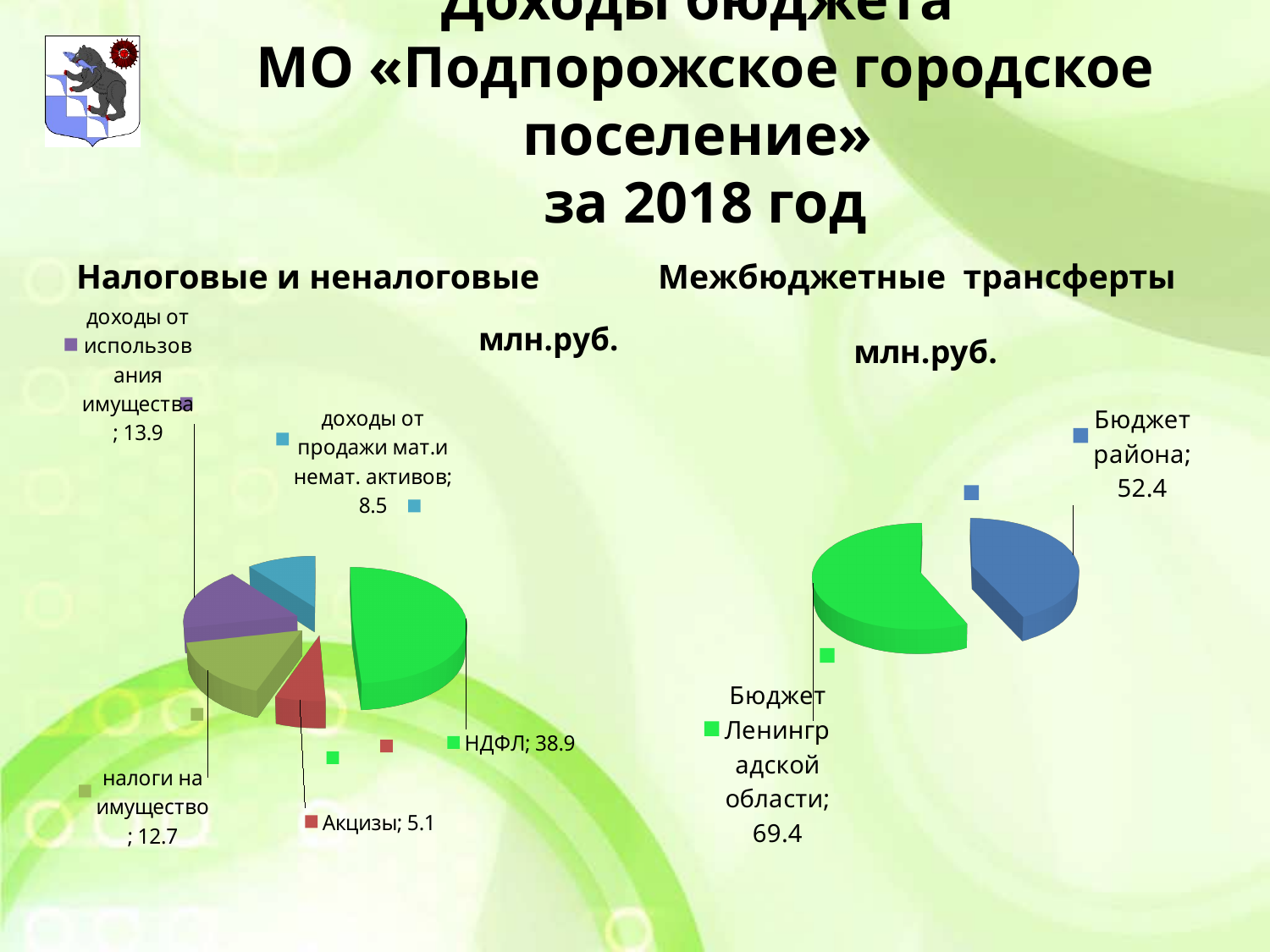
In the «Межбюджетные трансферты» chart, what is the value for Бюджет Ленинградской области? 69.4 In the «Налоговые и неналоговые» chart, how many categories are shown? 5 In the «Налоговые и неналоговые» chart, what is the value for НДФЛ? 38.9 In the «Налоговые и неналоговые» chart, what is the value for налоги на имущество? 12.7 In the «Налоговые и неналоговые» chart, what is the difference between НДФЛ and доходы от использования имущества? 25.0 In the «Налоговые и неналоговые» chart, which category has the largest value? НДФЛ In the «Межбюджетные трансферты» chart, what is the value for Бюджет района? 52.4 In the «Межбюджетные трансферты» chart, what is the difference between Бюджет Ленинградской области and Бюджет района? 17.0 In the «Налоговые и неналоговые» chart, what is the value for Акцизы? 5.1 What type of chart is used for «Налоговые и неналоговые»? pie chart In the «Налоговые и неналоговые» chart, which category has the smallest value? Акцизы In the «Межбюджетные трансферты» chart, which is larger: Бюджет района or Бюджет Ленинградской области? Бюджет Ленинградской области